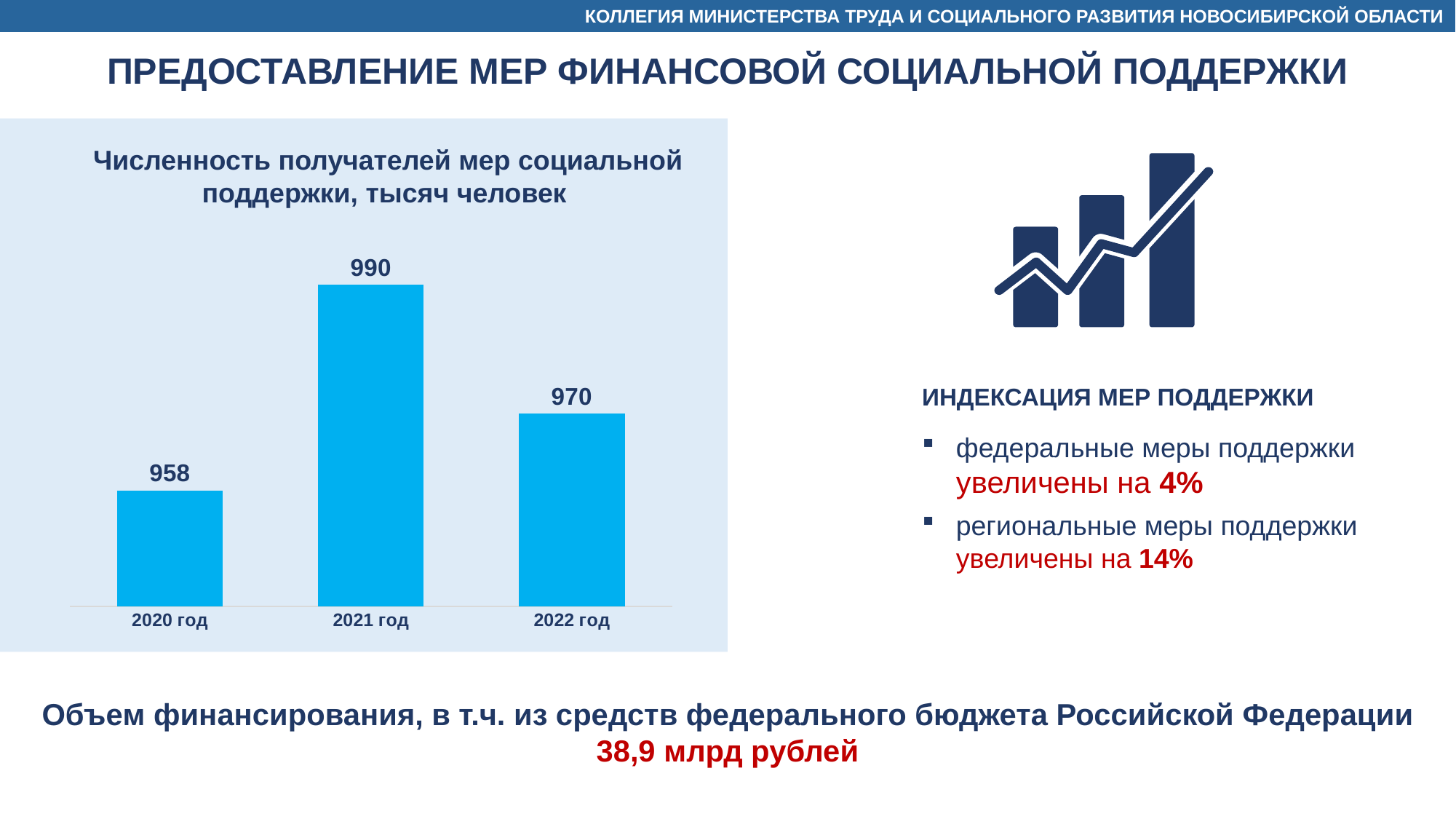
Which year has the highest number of recipients of social support measures? 2021 год What is the value for 2022 год in the chart? 970 Which is larger, the value for 2022 год or the value for 2020 год? 2022 год Which year has the lowest number of recipients of social support measures? 2020 год How many years (categories) are shown in the chart? 3 What is the value for 2021 год in the chart? 990 What is the title of the chart? Численность получателей мер социальной поддержки, тысяч человек What is the value for 2020 год in the chart? 958 What is the difference between the values for 2021 год and 2022 год? 20 What kind of chart is shown on the slide? Bar chart Does the value rise or fall from 2021 год to 2022 год? Fall What is the difference between the values for 2021 год and 2020 год? 32